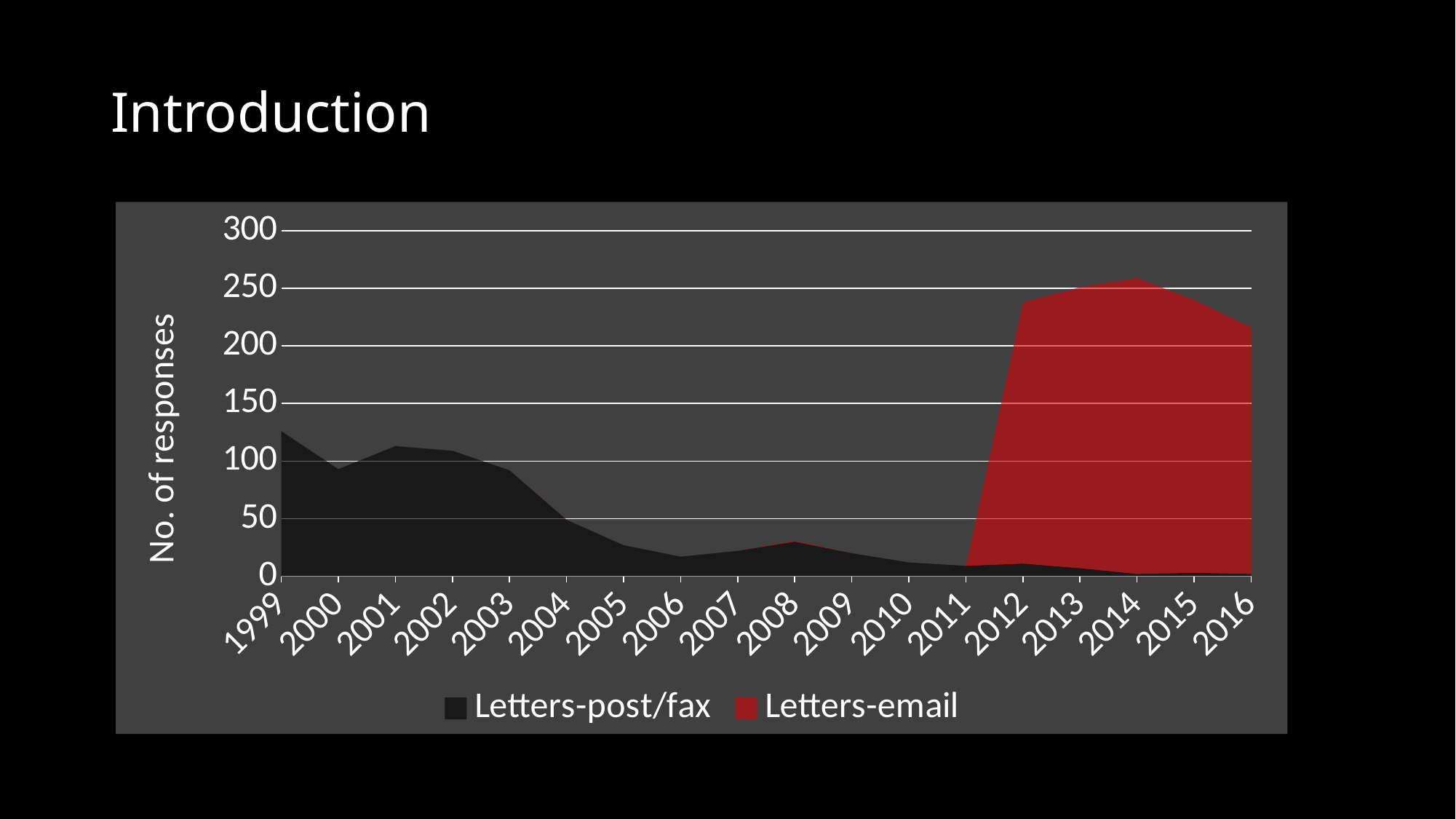
Is the value for Letters-email in 2014 greater or less than 250? greater Is the value for Letters-email in 2016 greater or less than 200? greater How many years are shown along the x axis? 18 Which is larger: Letters-email in 2016 or Letters-post/fax in 1999? Letters-email in 2016 Is the value for Letters-post/fax in 2005 greater or less than 50? less In which year is the Letters-post/fax series highest? 1999 Does the Letters-post/fax series generally rise or fall from 1999 to 2016? Fall What kind of chart is shown on the slide? Area chart What is the label on the vertical axis? No. of responses How many series does the legend list? 2 In which year is the Letters-email series highest? 2014